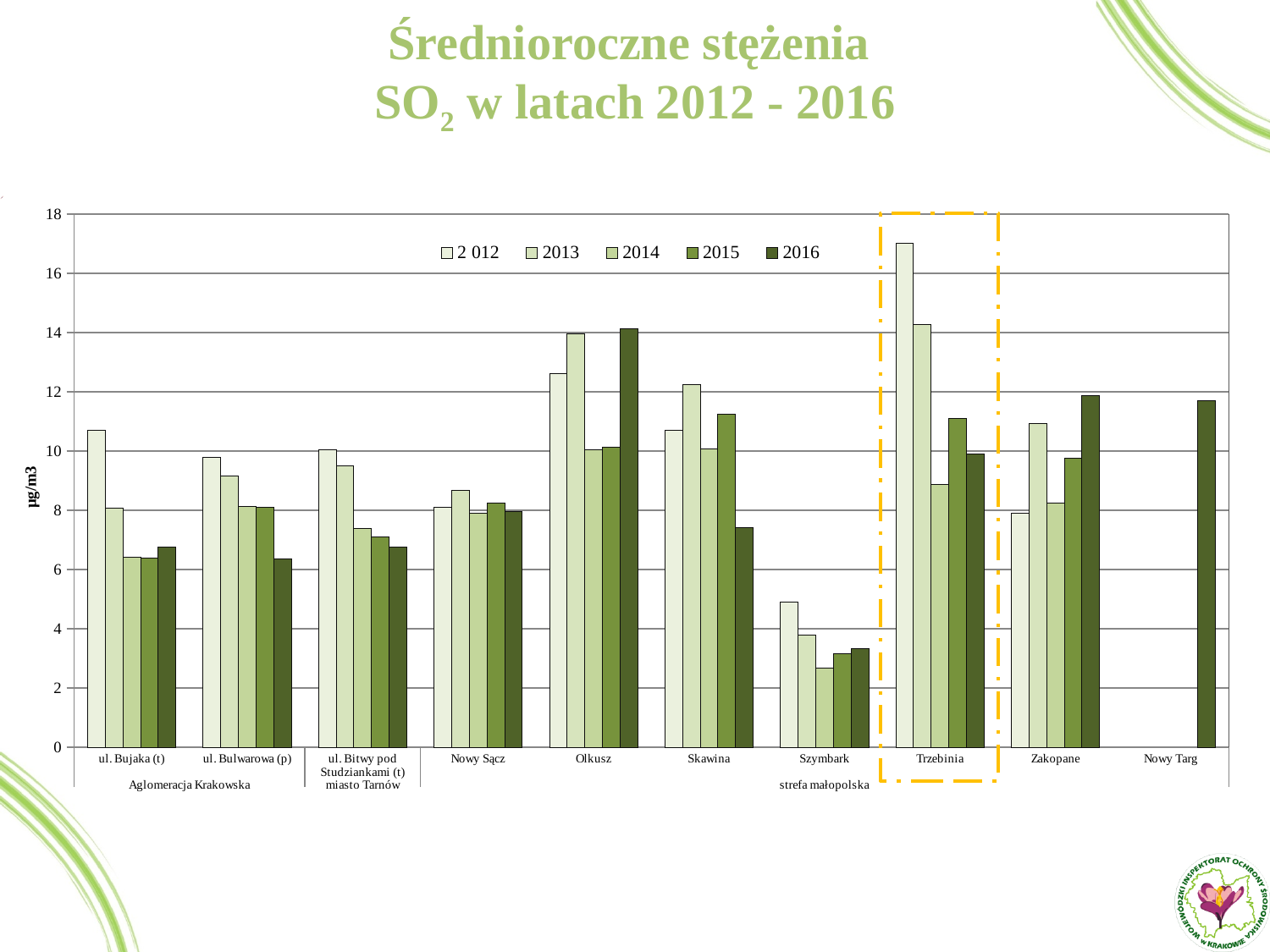
Do the values for ul. Bitwy pod Studziankami (t) rise or fall from 2012 to 2016? fall How many series does the legend list? 5 How many measurement stations (categories) are shown on the x axis? 10 Which is larger, the 2016 value for Olkusz or the 2016 value for Skawina? Olkusz Is the 2016 value for Nowy Targ greater or less than 10? greater Is the 2012 value for Trzebinia greater or less than 16? greater What unit is shown on the y axis? µg/m3 Which station has the highest value for 2016? Olkusz Is the 2014 value for Szymbark greater or less than 4? less Which station has the highest value for 2012? Trzebinia Which station has the lowest value for 2012? Szymbark What kind of chart is shown on the slide? bar chart